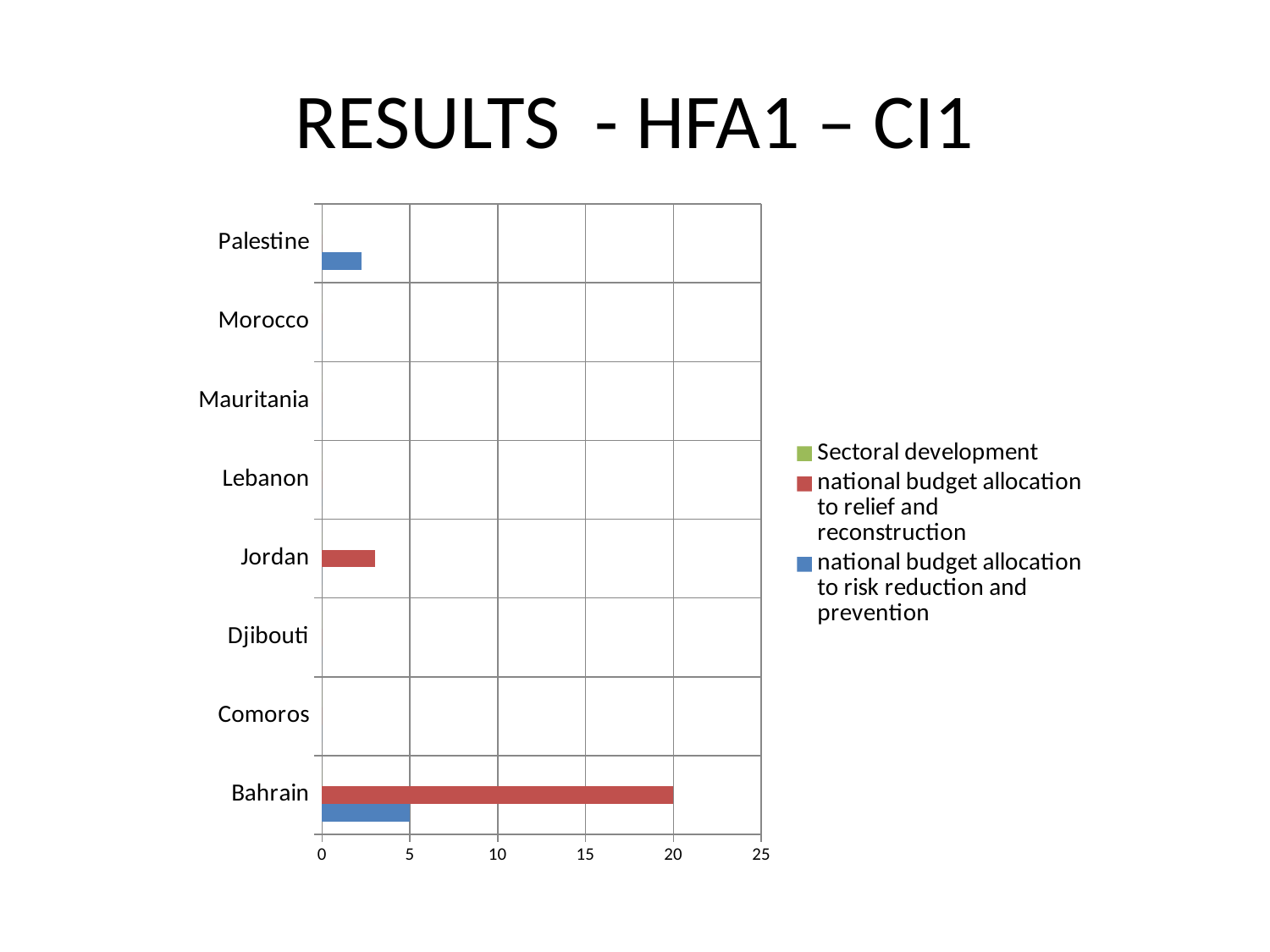
How many countries are listed on the vertical axis of the chart? 8 Is the value for Palestine's national budget allocation to risk reduction and prevention greater or less than 5? less What colour represents the Sectoral development series in the legend? green What kind of chart is shown on the slide? bar chart What is the value of national budget allocation to relief and reconstruction for Bahrain? 20 Which country has the highest value for national budget allocation to risk reduction and prevention? Bahrain Which country has the highest value for national budget allocation to relief and reconstruction? Bahrain Is the value for Jordan's national budget allocation to relief and reconstruction greater or less than 5? less What is the value of national budget allocation to risk reduction and prevention for Bahrain? 5 How many series does the legend list? 3 What is the difference between Bahrain's allocation to relief and reconstruction and its allocation to risk reduction and prevention? 15 For Bahrain, which is larger: the allocation to relief and reconstruction or the allocation to risk reduction and prevention? relief and reconstruction